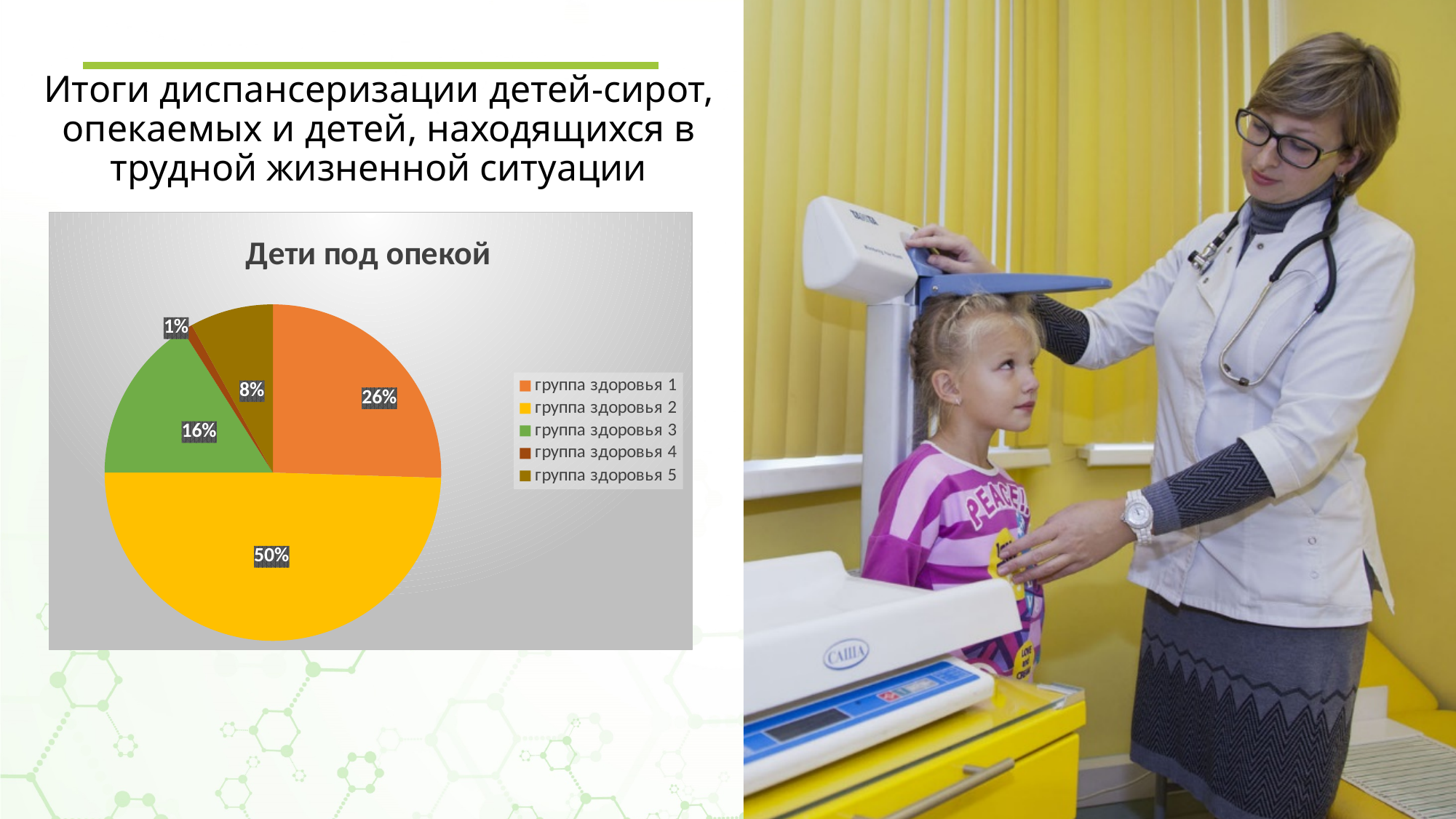
What is the difference in percentage points between группа здоровья 2 and группа здоровья 1? 24 Which health group has the smallest share of the pie? группа здоровья 4 What share of the pie does группа здоровья 2 have? 50% What share of the pie does группа здоровья 3 have? 16% What share of the pie does группа здоровья 1 have? 26% Which health group has the largest share of the pie? группа здоровья 2 How many entries does the legend list? 5 What is the title of the chart? Дети под опекой What kind of chart is shown on the slide? pie chart Which is larger, the share for группа здоровья 3 or the share for группа здоровья 5? группа здоровья 3